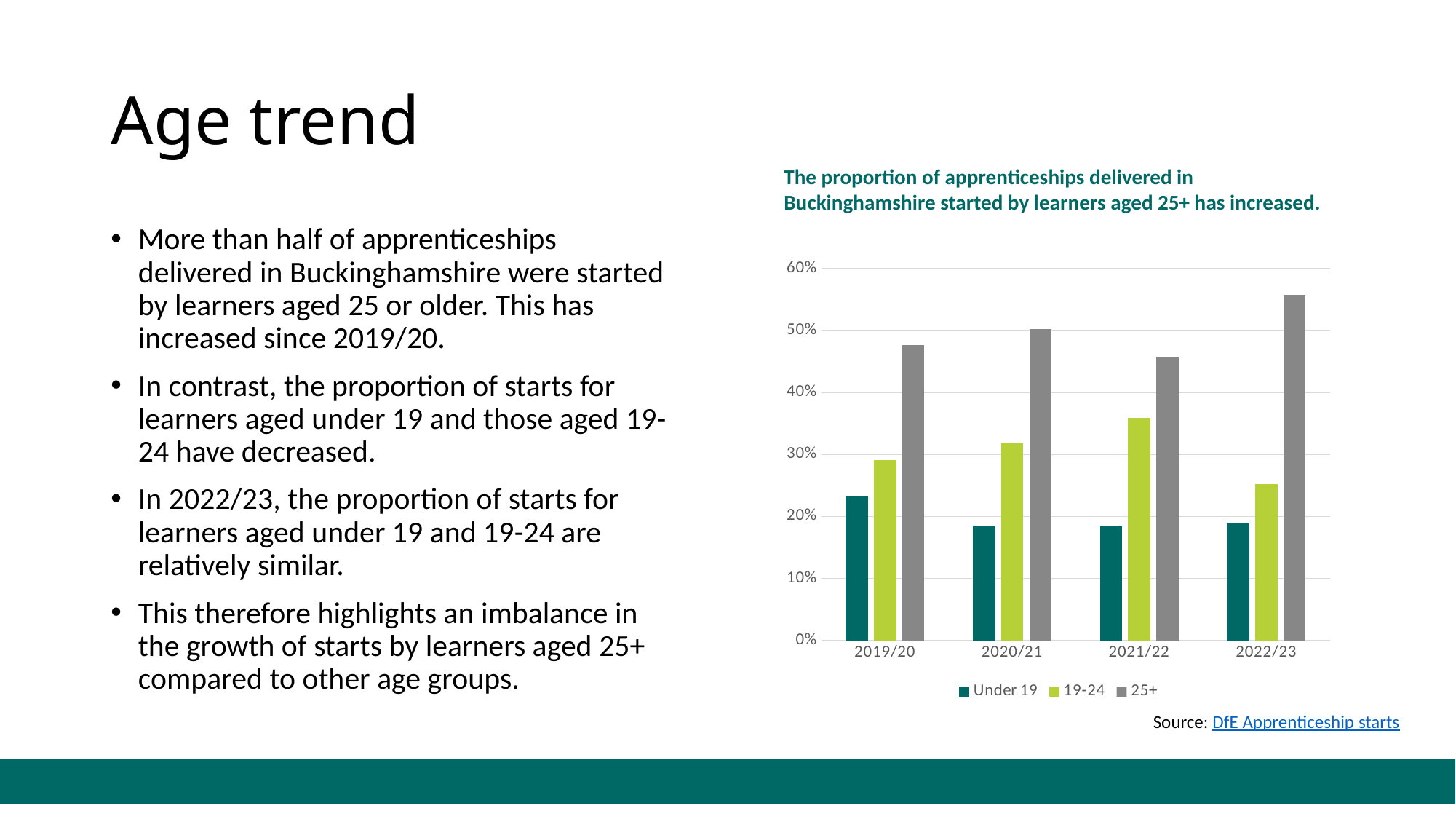
What kind of chart is shown on the slide? bar chart How many academic years are shown on the x axis of the chart? 4 In which year is the 25+ series at its highest? 2022/23 Is the value for 19-24 in 2021/22 greater or less than 30%? greater In which year is the 19-24 series at its highest? 2021/22 Which series is shown in grey in the chart legend? 25+ How many series does the chart legend list? 3 Is the value for Under 19 in 2020/21 greater or less than 20%? less Is the value for 25+ in 2019/20 greater or less than 50%? less In which year is the 19-24 series at its lowest? 2022/23 In 2022/23, which is larger: the value for Under 19 or the value for 19-24? 19-24